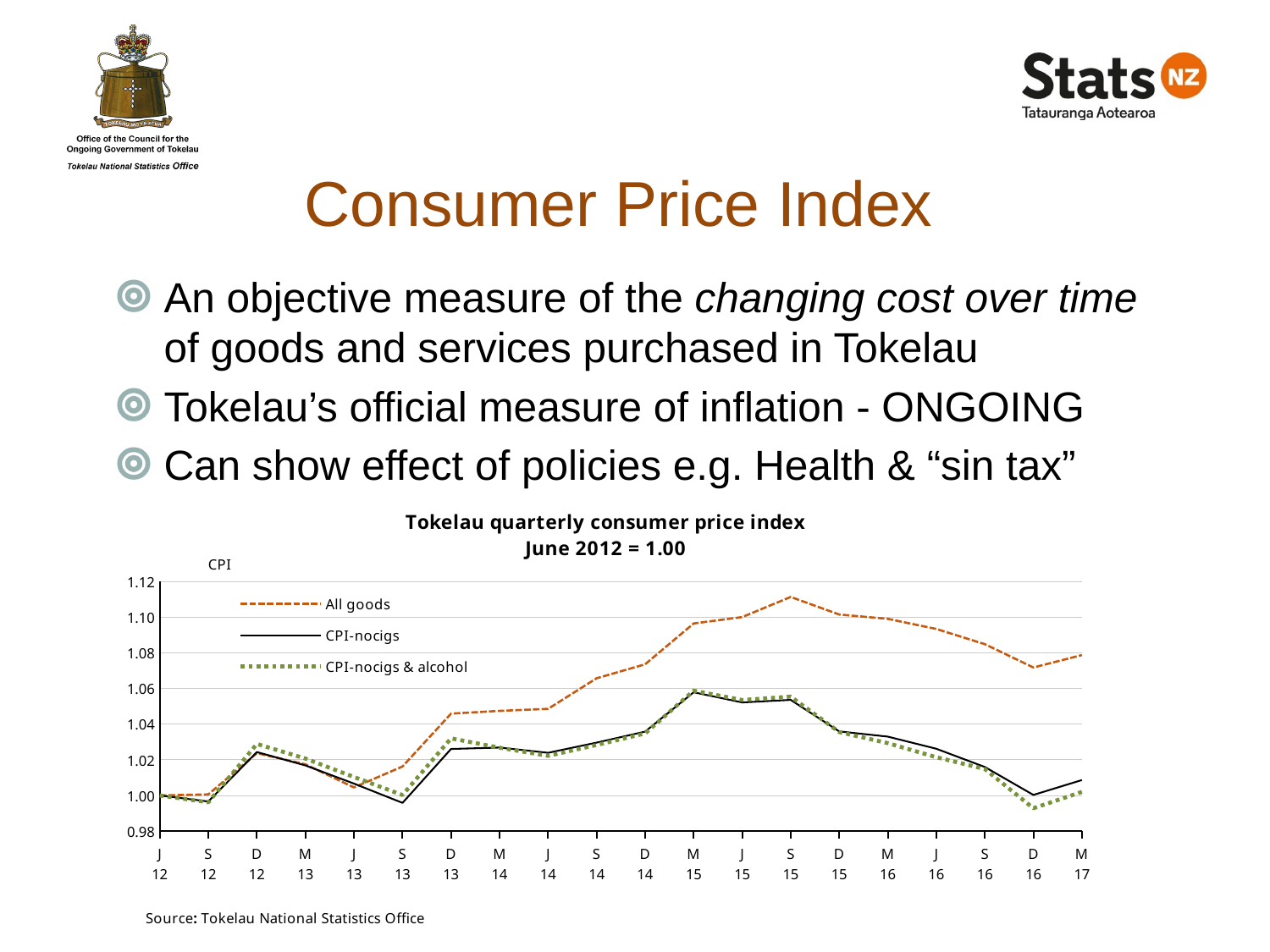
Does the All goods series rise or fall between D 15 and D 16? fall How many quarterly points are plotted along the x axis of the chart? 20 Which quarter is the base period where the index equals 1.00? June 2012 Is the All goods value in D 16 greater or less than 1.08? less In S 15, which series has the larger value, All goods or CPI-nocigs? All goods Is the CPI-nocigs value in M 15 greater or less than 1.04? greater Is the All goods value in S 15 greater or less than 1.10? greater How many series does the chart legend list? 3 In which quarter does the All goods series reach its highest value? S 15 What is the title of the chart? Tokelau quarterly consumer price index What kind of chart is shown on the slide? line chart